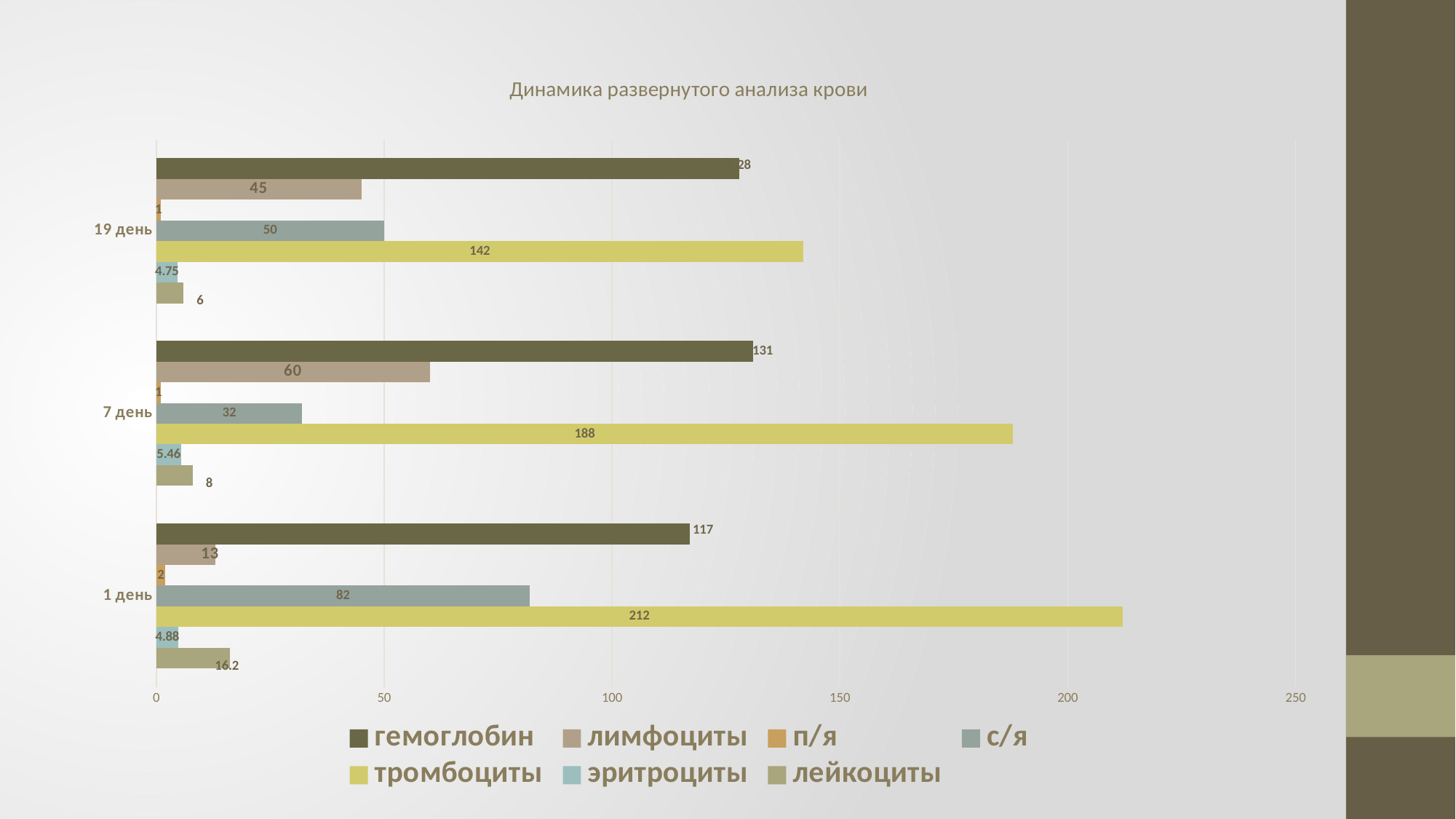
What is the value of эритроциты for 19 день? 4.75 What is the title of the chart? Динамика развернутого анализа крови How many categories (days) are shown on the vertical axis? 3 For which day is the тромбоциты value highest? 1 день What is the value of гемоглобин for 7 день? 131 For which day is the лимфоциты value lowest? 1 день What is the difference between the тромбоциты values for 7 день and 19 день? 46 Which is larger: с/я for 1 день or с/я for 7 день? 1 день How many series does the legend list? 7 What is the value of тромбоциты for 1 день? 212 What is the value of лейкоциты for 1 день? 16.2 What type of chart is shown on the slide? bar chart